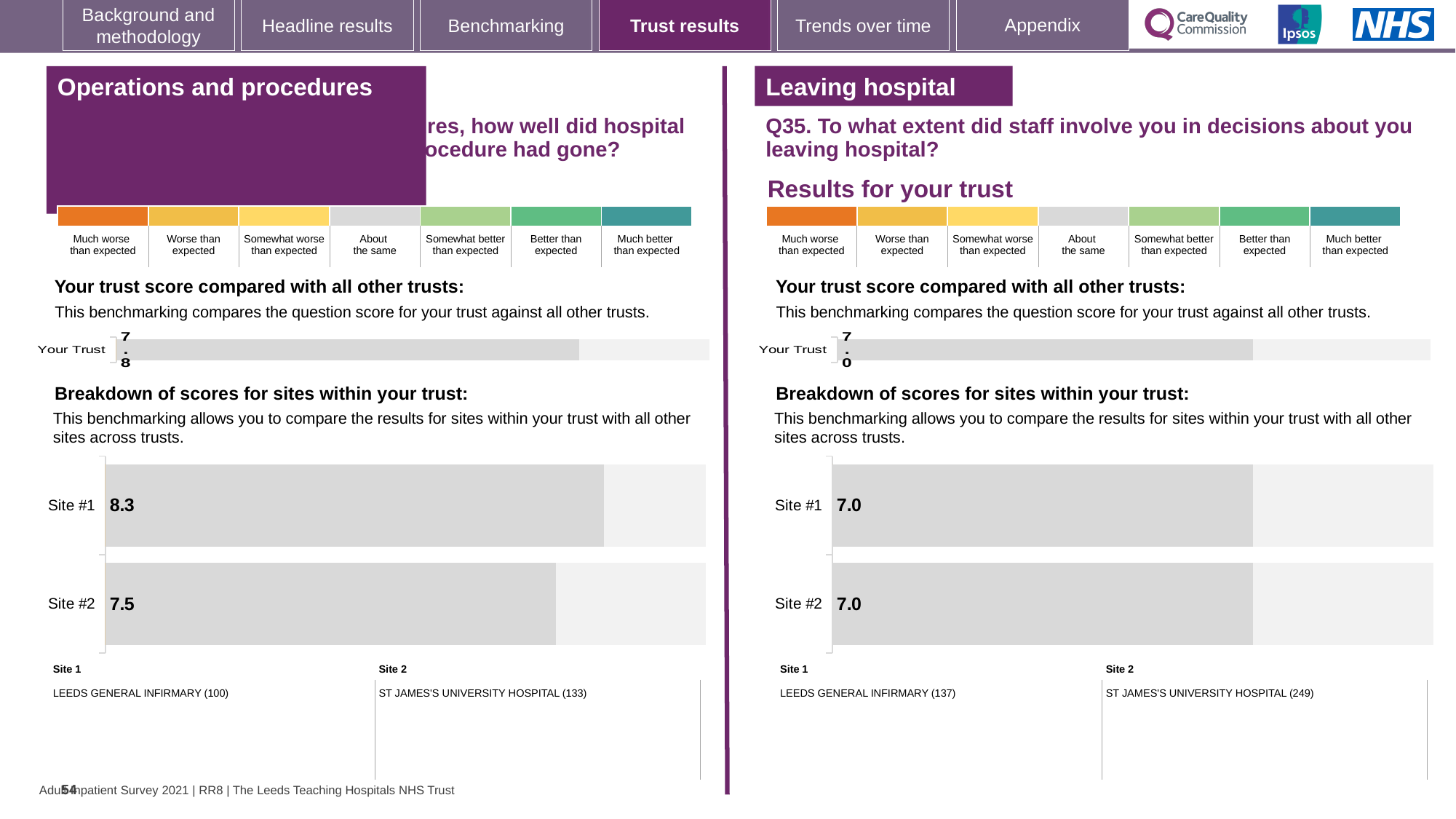
In the 'Leaving hospital' section (Q35), what is the score shown for Site #1 in the breakdown of scores for sites chart? 7.0 In the 'Operations and procedures' section, what is the score shown for Site #1 in the breakdown of scores for sites chart? 8.3 In the 'Operations and procedures' section, what is the 'Your Trust' score in the trust comparison chart? 7.8 In the 'Leaving hospital' section (Q35), what is the 'Your Trust' score in the trust comparison chart? 7.0 In the 'Leaving hospital' site breakdown chart, what is the difference between the Site #1 and Site #2 scores? 0 In the 'Operations and procedures' site breakdown chart, what is the difference between the Site #1 and Site #2 scores? 0.8 In the 'Leaving hospital' section (Q35), what is the score shown for Site #2 in the breakdown of scores for sites chart? 7.0 How many sites are shown in the 'Leaving hospital' breakdown of scores for sites chart? 2 In the 'Operations and procedures' site breakdown chart, which site has the lower score? Site #2 In the 'Operations and procedures' section, what is the score shown for Site #2 in the breakdown of scores for sites chart? 7.5 What type of chart is used for the breakdown of scores for sites in the 'Operations and procedures' section? Bar chart In the 'Operations and procedures' site breakdown chart, which site has the higher score? Site #1